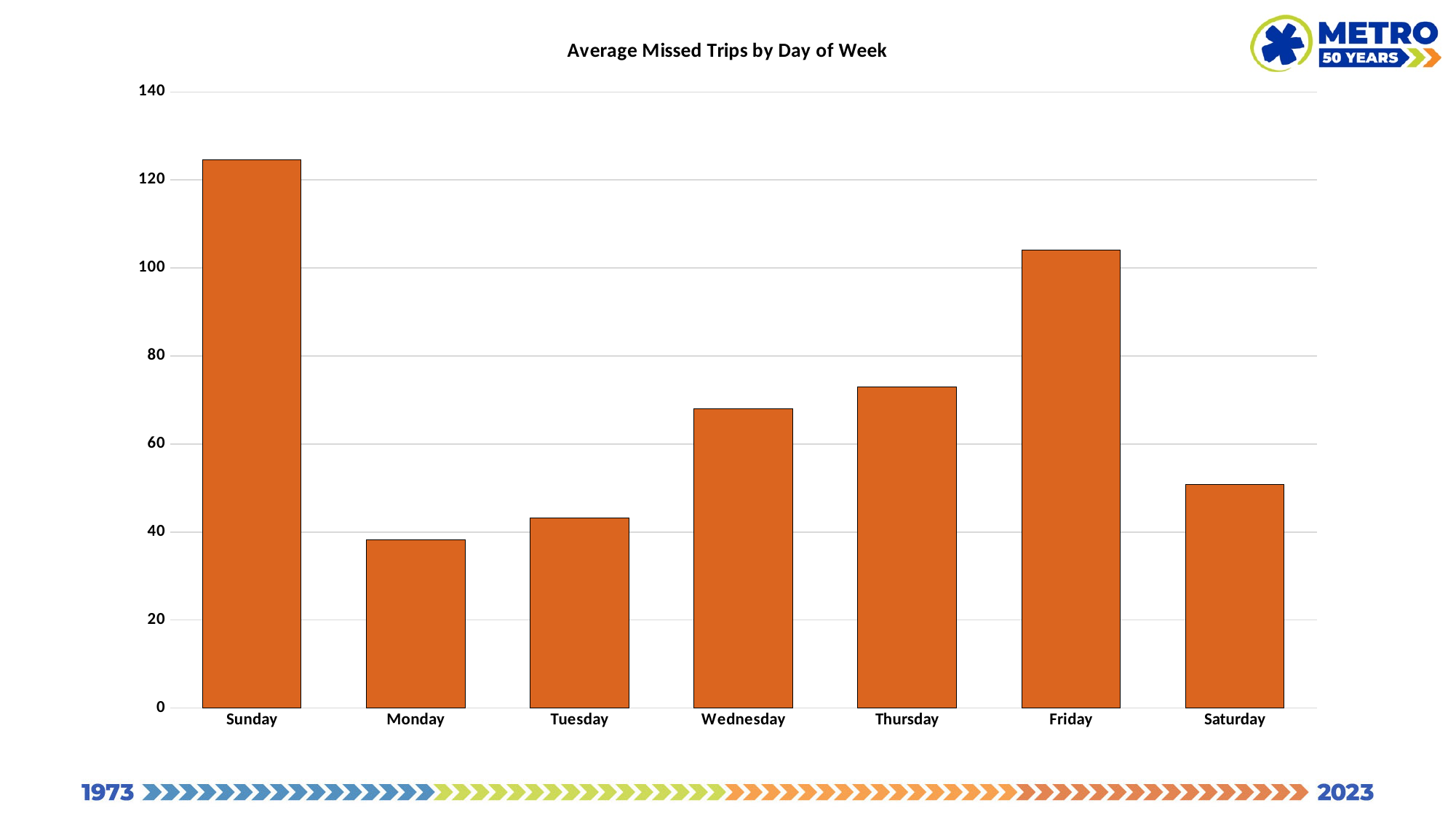
Is the value for Monday greater or less than 40? less Is the value for Sunday greater or less than 120? greater Is the value for Wednesday greater or less than 60? greater Which day has the highest average missed trips? Sunday Which is larger, the value for Saturday or the value for Monday? Saturday What is the title of the chart? Average Missed Trips by Day of Week How many days of the week are shown on the x axis? 7 What type of chart is shown on the slide? bar chart Which day has the lowest average missed trips? Monday Which is larger, the value for Friday or the value for Thursday? Friday